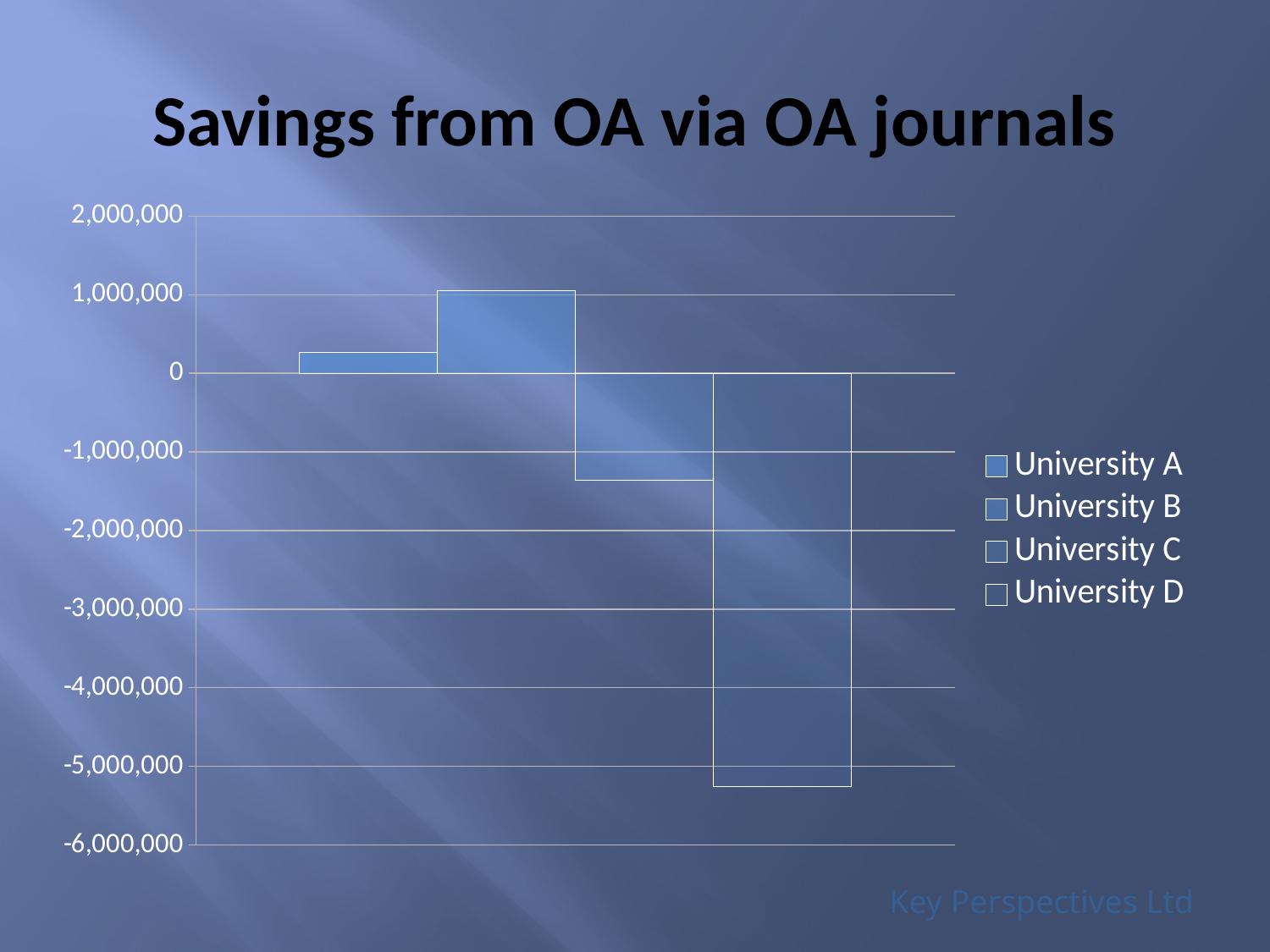
Which is larger, the value for University A or University B? University B Is the value for University A greater or less than 1,000,000? less What is the title of the chart? Savings from OA via OA journals Which university has the highest value? University B Is the value for University D greater or less than -5,000,000? less How many bars are plotted in the chart? 4 What kind of chart is shown on the slide? bar chart Which university has the lowest value? University D How many series does the legend list? 4 Do the values rise or fall from University B to University D? fall Is the value for University C greater or less than -1,000,000? less Which is larger, the value for University C or University D? University C